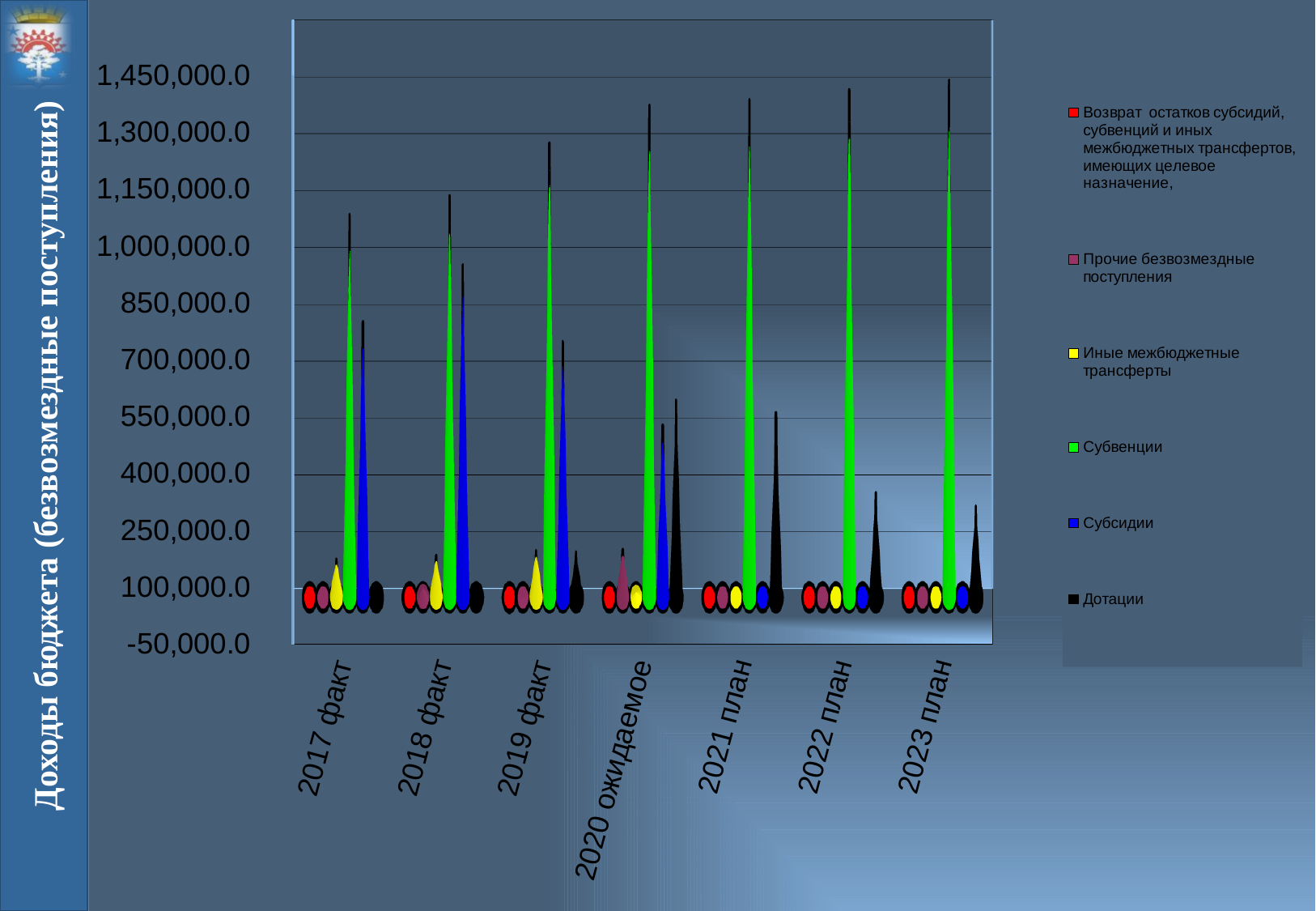
How many series does the chart's legend list? 6 Is the value of Субсидии for 2018 факт greater or less than 700,000.0? greater What kind of chart is shown on the slide? bar chart Which series has the highest value in the 2017 факт category? Субвенции Which colour represents the Субвенции series in the legend? green Is the value of Субвенции for 2017 факт greater or less than 850,000.0? greater Is the value of Дотации for 2022 план greater or less than 400,000.0? less In the 2018 факт category, which is larger: Субвенции or Субсидии? Субвенции How many categories are shown on the x axis of the chart? 7 Which series has the highest value in the 2019 факт category? Субвенции